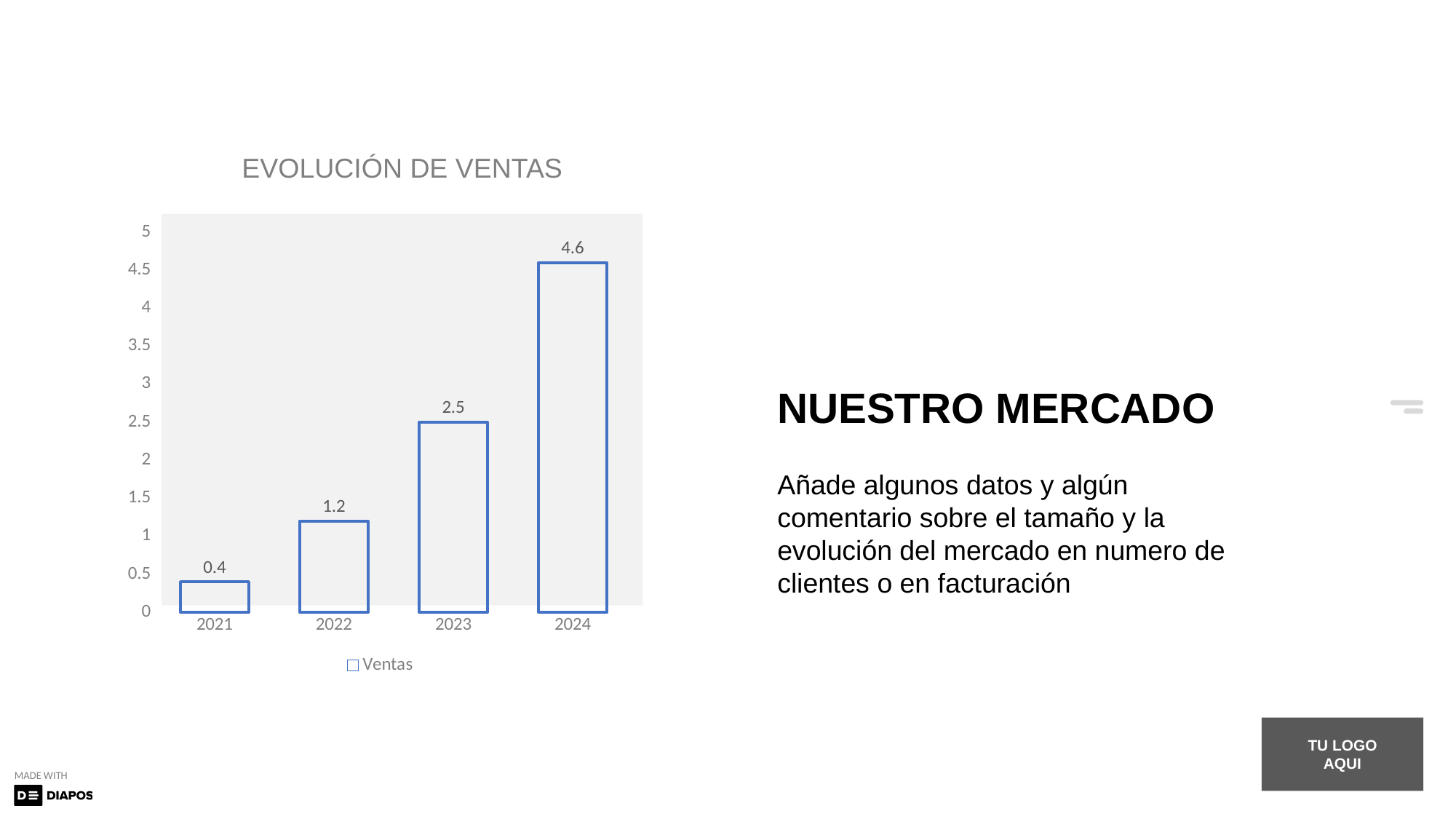
What is the difference between the values for 2022 and 2021 in the EVOLUCIÓN DE VENTAS chart? 0.8 Do the values in the EVOLUCIÓN DE VENTAS chart rise or fall from 2021 to 2024? rise Is the value for 2024 in the EVOLUCIÓN DE VENTAS chart greater or less than 4? greater What is the value for 2023 in the EVOLUCIÓN DE VENTAS chart? 2.5 What is the value for 2024 in the EVOLUCIÓN DE VENTAS chart? 4.6 Which year has the highest value in the EVOLUCIÓN DE VENTAS chart? 2024 Which is larger in the EVOLUCIÓN DE VENTAS chart, the value for 2022 or the value for 2023? 2023 What kind of chart is EVOLUCIÓN DE VENTAS? bar chart How many years are shown on the x axis of the EVOLUCIÓN DE VENTAS chart? 4 What is the value for 2021 in the EVOLUCIÓN DE VENTAS chart? 0.4 Which year has the lowest value in the EVOLUCIÓN DE VENTAS chart? 2021 What is the difference between the values for 2024 and 2023 in the EVOLUCIÓN DE VENTAS chart? 2.1